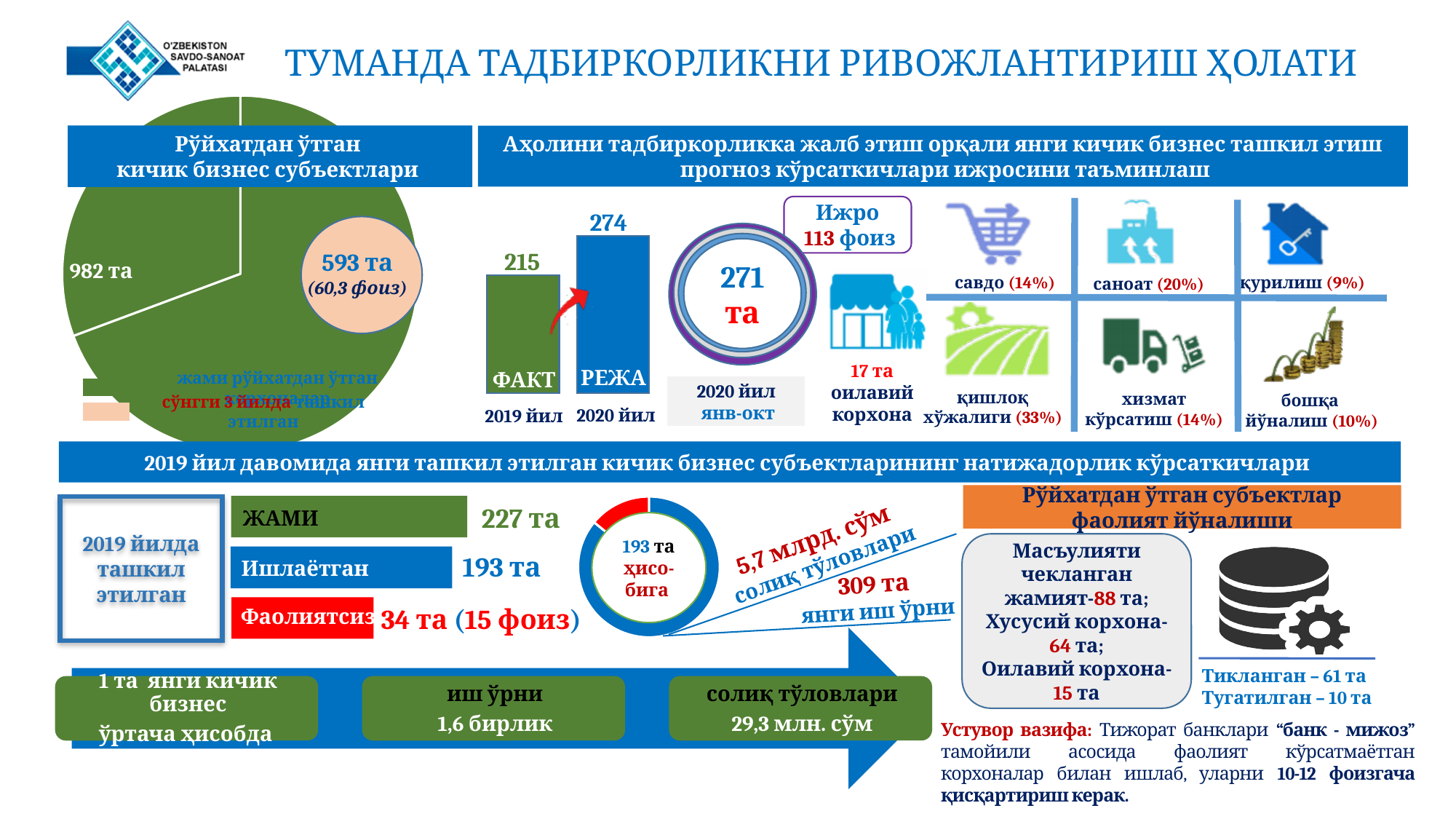
What kind of chart is used to compare ФАКТ 2019 йил and РЕЖА 2020 йил? bar chart In the bar chart comparing ФАКТ and РЕЖА, what is the value for РЕЖА (2020 йил)? 274 In the horizontal bar chart under '2019 йилда ташкил этилган', which category has the lowest value? Фаолиятсиз In the pie chart titled 'Рўйхатдан ўтган кичик бизнес субъектлари', what share of the total is the 593 та slice? 60,3 фоиз In the horizontal bar chart under '2019 йилда ташкил этилган', what is the value for Ишлаётган? 193 та In the bar chart comparing ФАКТ and РЕЖА, how many bars are plotted? 2 In the horizontal bar chart under '2019 йилда ташкил этилган', what is the value for Фаолиятсиз? 34 та (15 фоиз) In the bar chart comparing ФАКТ and РЕЖА, what is the value for ФАКТ (2019 йил)? 215 In the bar chart comparing ФАКТ and РЕЖА, which bar is higher? РЕЖА (2020 йил) In the horizontal bar chart under '2019 йилда ташкил этилган', what is the difference between ЖАМИ and Ишлаётган? 34 та In the bar chart comparing ФАКТ and РЕЖА, what is the difference between the РЕЖА and ФАКТ values? 59 In the horizontal bar chart under '2019 йилда ташкил этилган', what is the value for ЖАМИ? 227 та